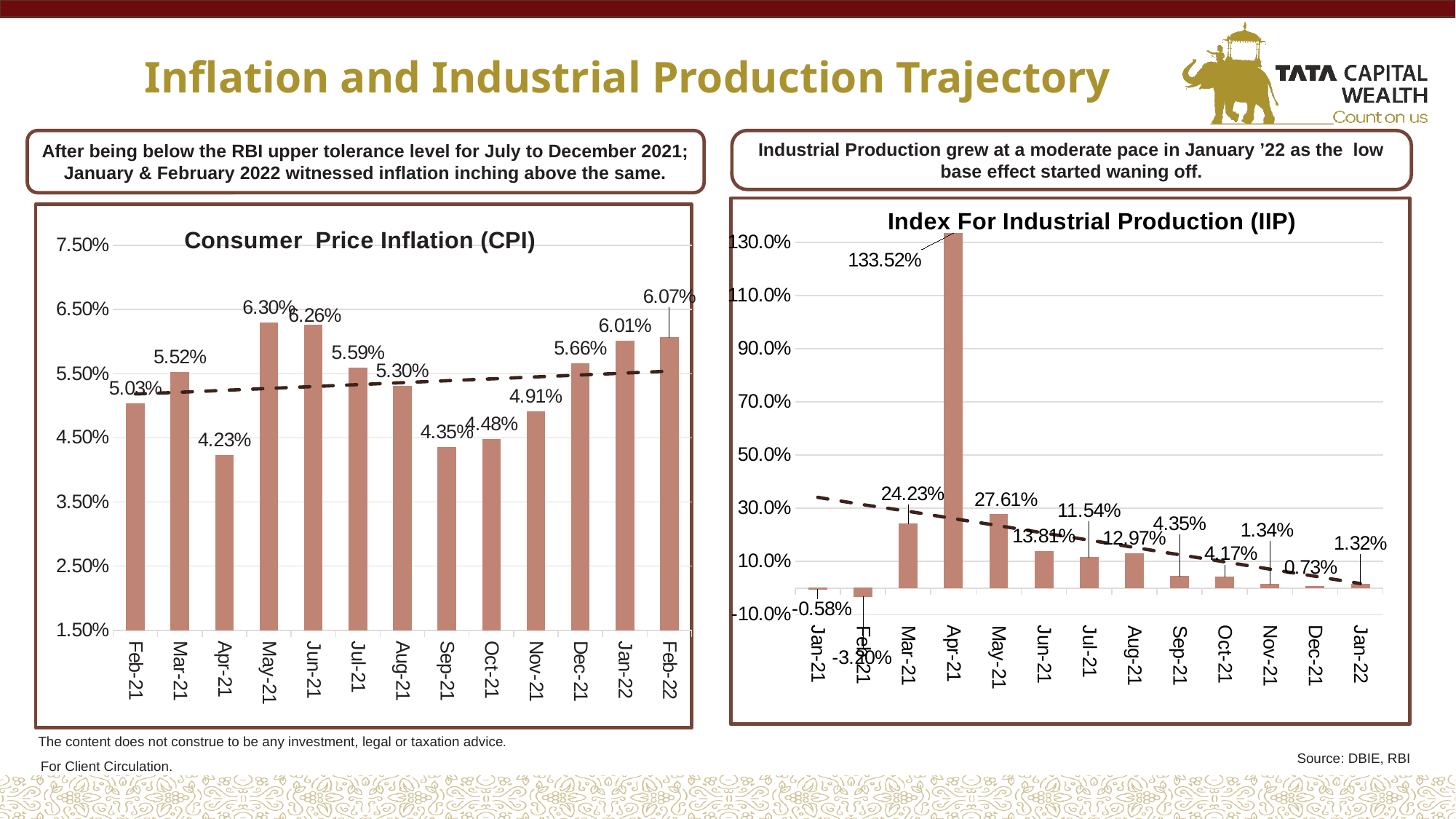
In the Index For Industrial Production (IIP) chart, which is larger, the value for Mar-21 or the value for May-21? May-21 In the Index For Industrial Production (IIP) chart, what is the value for Jan-22? 1.32% In the Consumer Price Inflation (CPI) chart, what is the value for Apr-21? 4.23% In the Index For Industrial Production (IIP) chart, what is the value for Apr-21? 133.52% In the Index For Industrial Production (IIP) chart, which month has the highest value? Apr-21 In the Consumer Price Inflation (CPI) chart, what is the value for Dec-21? 5.66% What kind of chart is the Index For Industrial Production (IIP) chart? Bar chart How many months are plotted in the Consumer Price Inflation (CPI) chart? 13 In the Consumer Price Inflation (CPI) chart, which month has the highest value? May-21 In the Consumer Price Inflation (CPI) chart, which month has the lowest value? Apr-21 In the Consumer Price Inflation (CPI) chart, how much higher is the Feb-22 value than the Feb-21 value? 1.04 percentage points In the Index For Industrial Production (IIP) chart, what is the difference between the May-21 and Mar-21 values? 3.38 percentage points